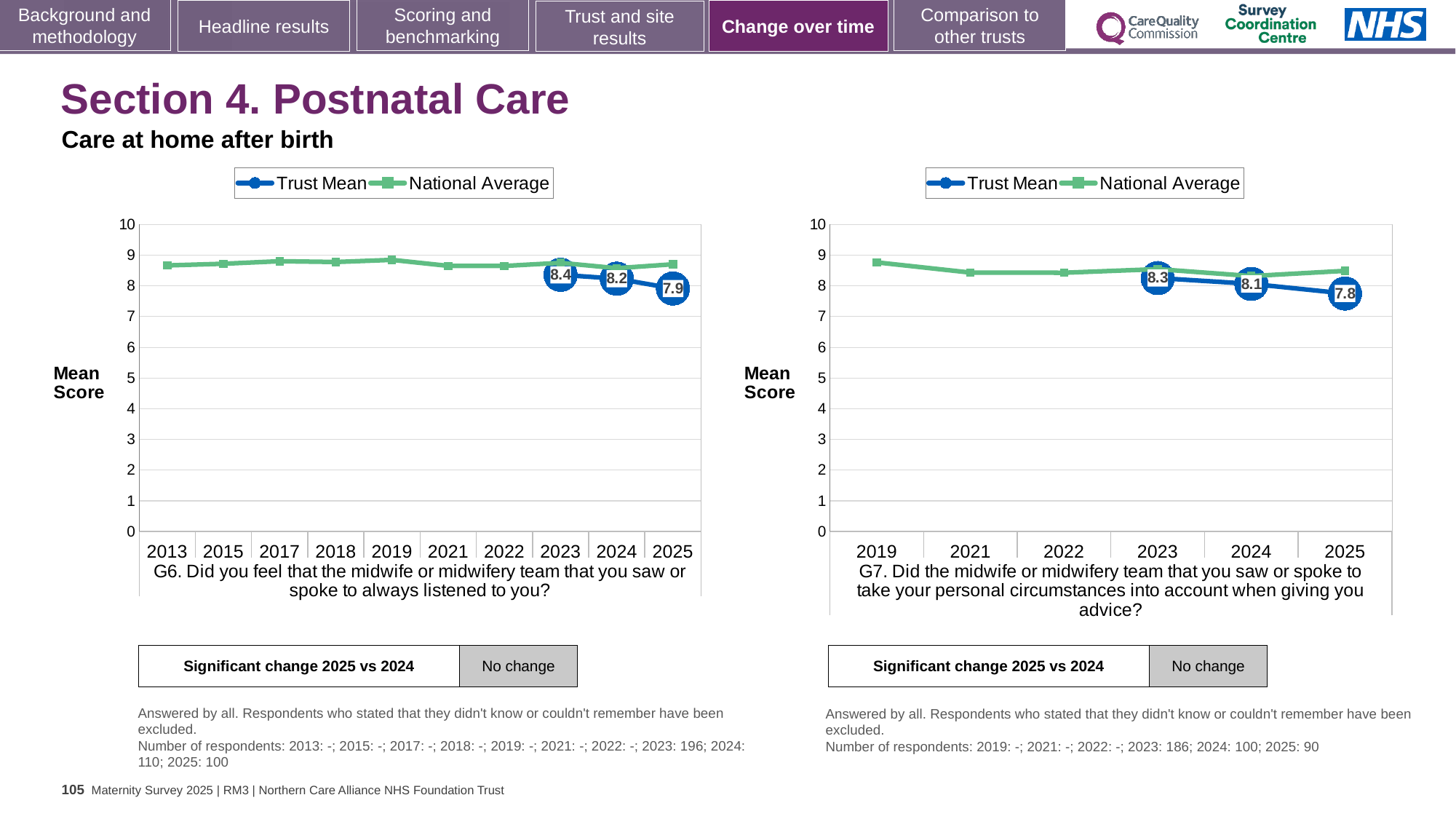
How many years are shown on the x axis of the left chart (G6)? 10 What kind of chart is the right chart (G7)? line chart In the left chart (G6), by how much did the Trust Mean fall from 2023 to 2025? 0.5 In the right chart (G7), what is the Trust Mean score for 2024? 8.1 In the left chart (G6), what is the Trust Mean score for 2025? 7.9 How many series does the legend of the left chart (G6) list? 2 In the left chart (G6), is the National Average for 2025 greater or less than 8? greater In the right chart (G7), what is the difference between the Trust Mean in 2023 and in 2025? 0.5 In the right chart (G7), does the Trust Mean rise or fall from 2023 to 2025? fall How many years are shown on the x axis of the right chart (G7)? 6 In the right chart (G7), what is the Trust Mean score for 2025? 7.8 In the left chart (G6), what is the Trust Mean score for 2023? 8.4